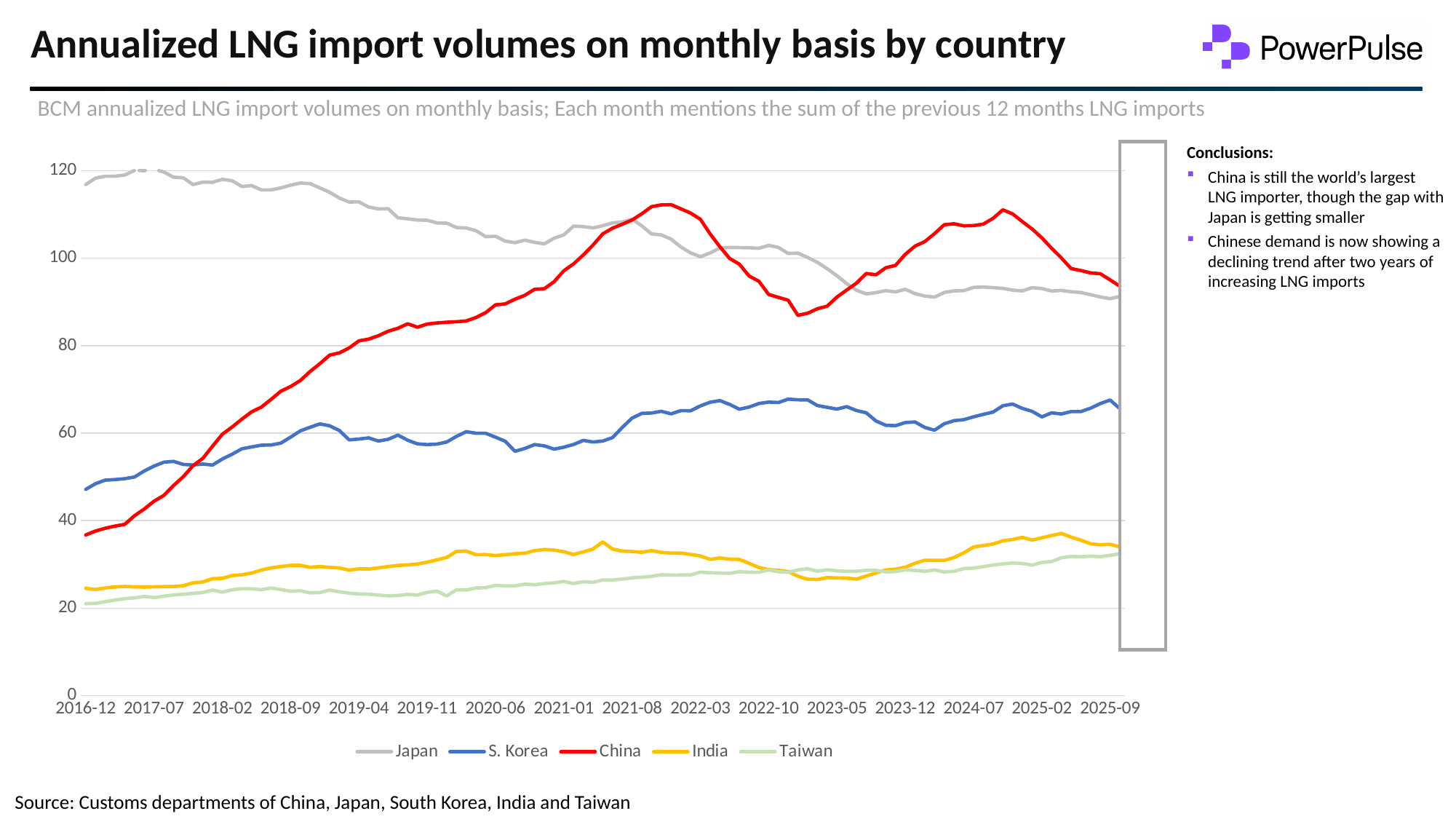
Which series has the highest value at 2016-12? Japan Does the value for China rise or fall from 2016-12 to 2025-09? rise Which series has the lowest value at 2016-12? Taiwan Is the value for S. Korea at 2025-09 greater or less than 60? greater Is the value for Japan at 2016-12 greater or less than 100? greater What kind of chart is shown on the slide? line chart At 2016-12, which is larger, the value for India or the value for Taiwan? India Which series has the highest value at 2025-09? China Is the value for China at 2016-12 greater or less than 40? less Does the value for Japan rise or fall from 2016-12 to 2025-09? fall Which series is drawn in red? China How many series does the legend list? 5